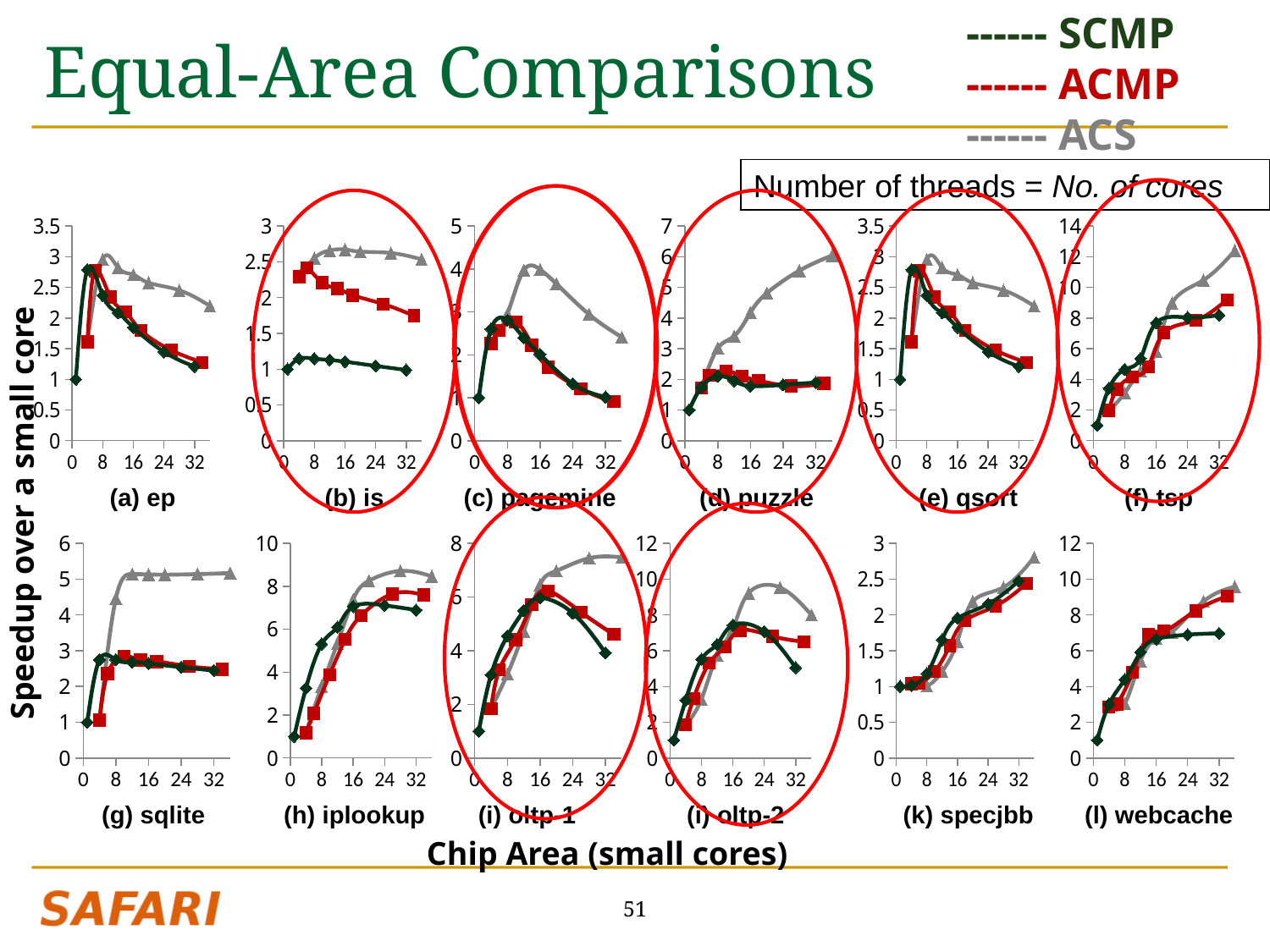
In the (k) specjbb chart, do the values rise or fall as chip area increases? rise In the (c) pagemine chart, is the ACS value at chip area 16 greater or less than 3? greater What is the label of the shared x axis for the charts? Chip Area (small cores) In the (b) is chart, which series is higher at chip area 32, SCMP or ACS? ACS In the (g) sqlite chart, is the ACS value at chip area 32 greater or less than 4? greater In the (b) is chart, is the ACS value at chip area 16 greater or less than 2? greater How many series does the legend at the top right list? 3 How many individual benchmark charts are shown on the slide? 12 What kind of chart is used for each of the panels on this slide? line chart What is the label of the shared y axis for the charts? Speedup over a small core In the (f) tsp chart, which series reaches the highest speedup at chip area 32? ACS